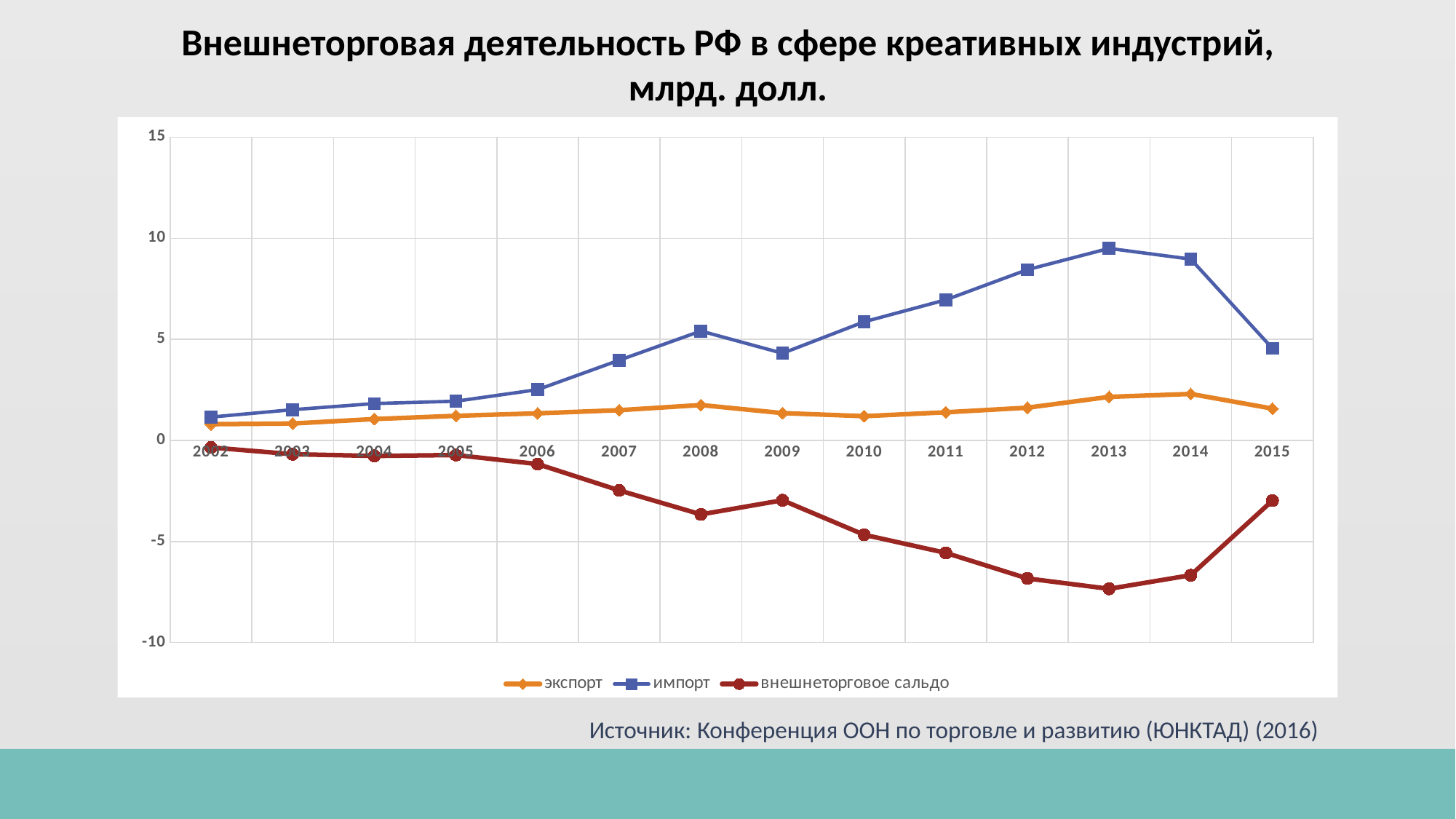
What kind of chart is shown on the slide? line chart What is the title of the chart? Внешнеторговая деятельность РФ в сфере креативных индустрий, млрд. долл. Does the импорт series rise or fall from 2009 to 2013? rise In which year does the внешнеторговое сальдо series reach its lowest value? 2013 In which year does the импорт series reach its highest value? 2013 How many years are plotted along the x axis? 14 Is the value for внешнеторговое сальдо in 2013 greater or less than -5? less Is the value for импорт in 2002 greater or less than 5? less Which is larger in 2013, импорт or экспорт? импорт How many series does the legend list? 3 Is the value for импорт in 2013 greater or less than 5? greater